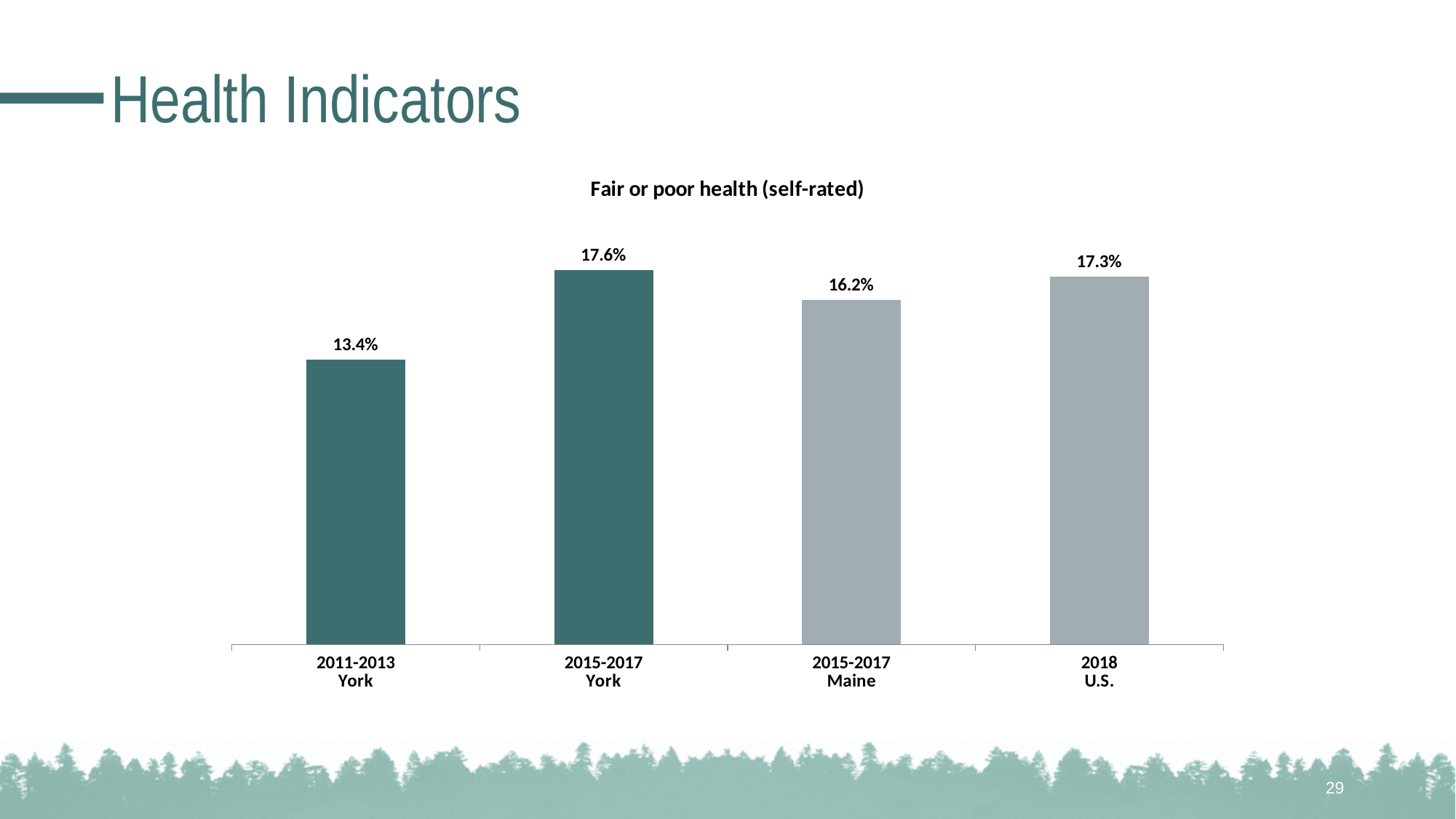
Which category has the lowest value? 2011-2013 York Which is larger, the value for 2015-2017 Maine or the value for 2018 U.S.? 2018 U.S. What is the value for 2015-2017 Maine? 16.2% What kind of chart is shown on the slide? Bar chart What is the difference between the 2018 U.S. value and the 2015-2017 Maine value? 1.1% What is the value for 2011-2013 York? 13.4% What is the title of the chart? Fair or poor health (self-rated) What is the value for 2018 U.S.? 17.3% Which category has the highest value? 2015-2017 York How many bars are shown in the chart? 4 What is the value for 2015-2017 York? 17.6% What is the difference between the 2015-2017 York value and the 2011-2013 York value? 4.2%